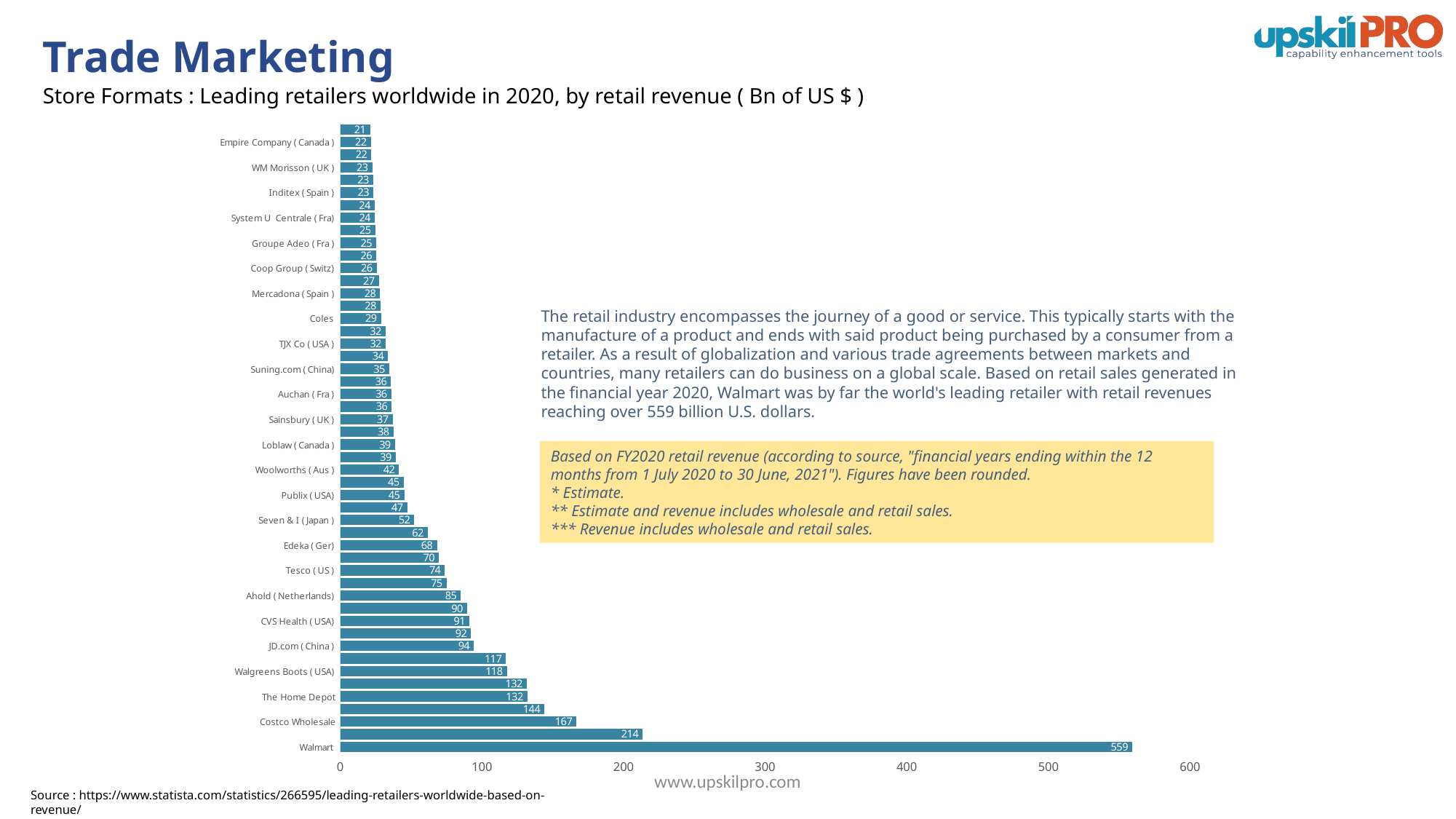
What is the value shown for The Home Depot? 132 Which has a larger value, Edeka (Ger) or Seven & I (Japan)? Edeka (Ger) What is the value shown for Coles? 29 What is the value shown for Tesco (US)? 74 What kind of chart is shown on the slide? Bar chart Is the value for Costco Wholesale greater or less than 100? greater What is the retail revenue value shown for Walmart? 559 What is the value shown for Costco Wholesale? 167 Which retailer has the highest retail revenue in the chart? Walmart What is the difference between the values for Walmart and Costco Wholesale? 392 Which has a larger value, Walgreens Boots (USA) or JD.com (China)? Walgreens Boots (USA) What is the subtitle describing the chart on the slide? Store Formats : Leading retailers worldwide in 2020, by retail revenue ( Bn of US $ )